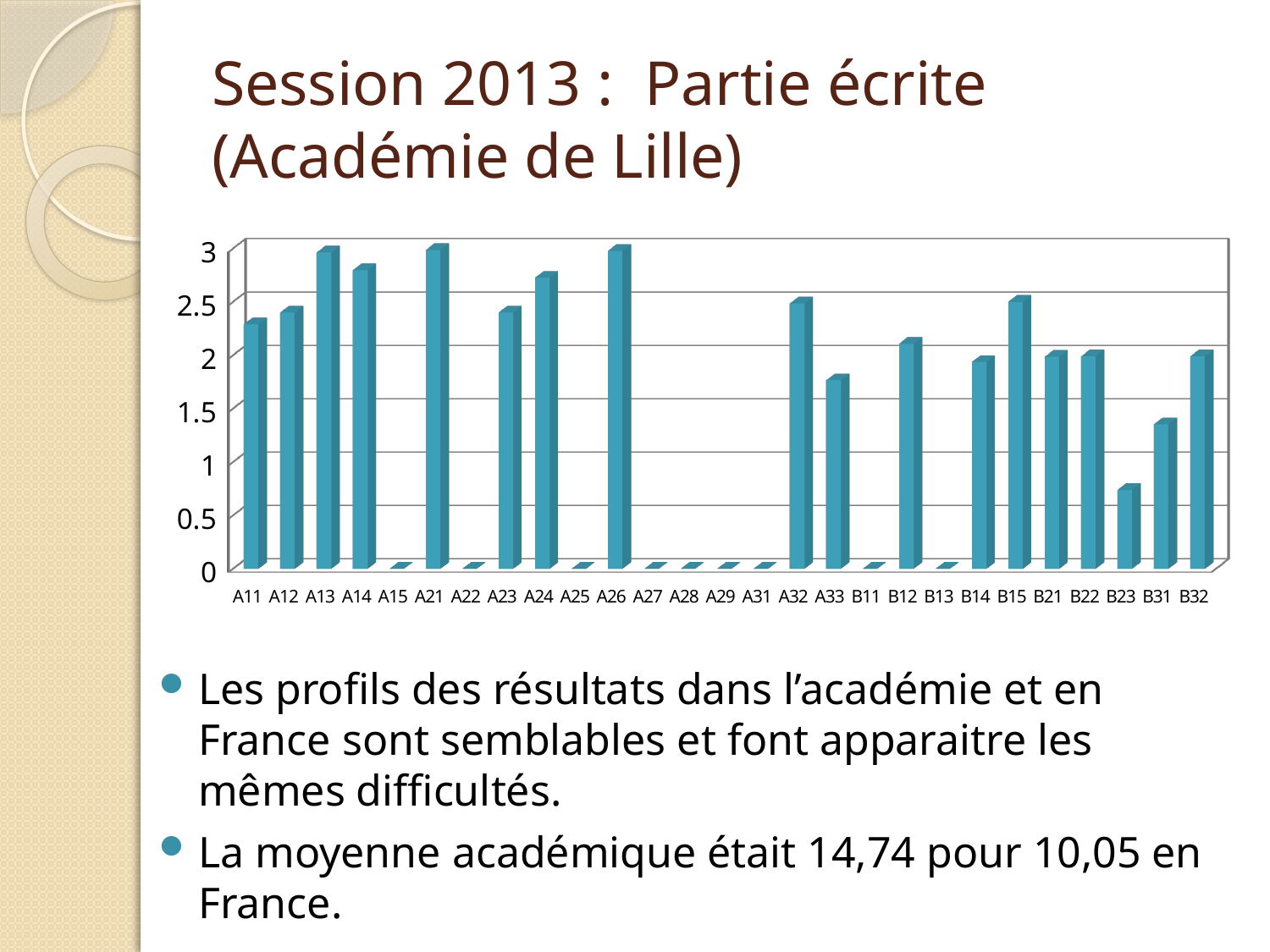
Is the value for A14 greater or less than 2.5? greater What colour are the bars in the chart? teal blue Is the value for A32 greater or less than 2? greater Which is larger, the value for B31 or the value for B23? B31 Which is larger, the value for A11 or the value for A33? A11 Is the value for B23 greater or less than 1? less Which is larger, the value for A13 or the value for B23? A13 What kind of chart is shown on the slide? bar chart How many categories are shown on the x axis of the chart? 27